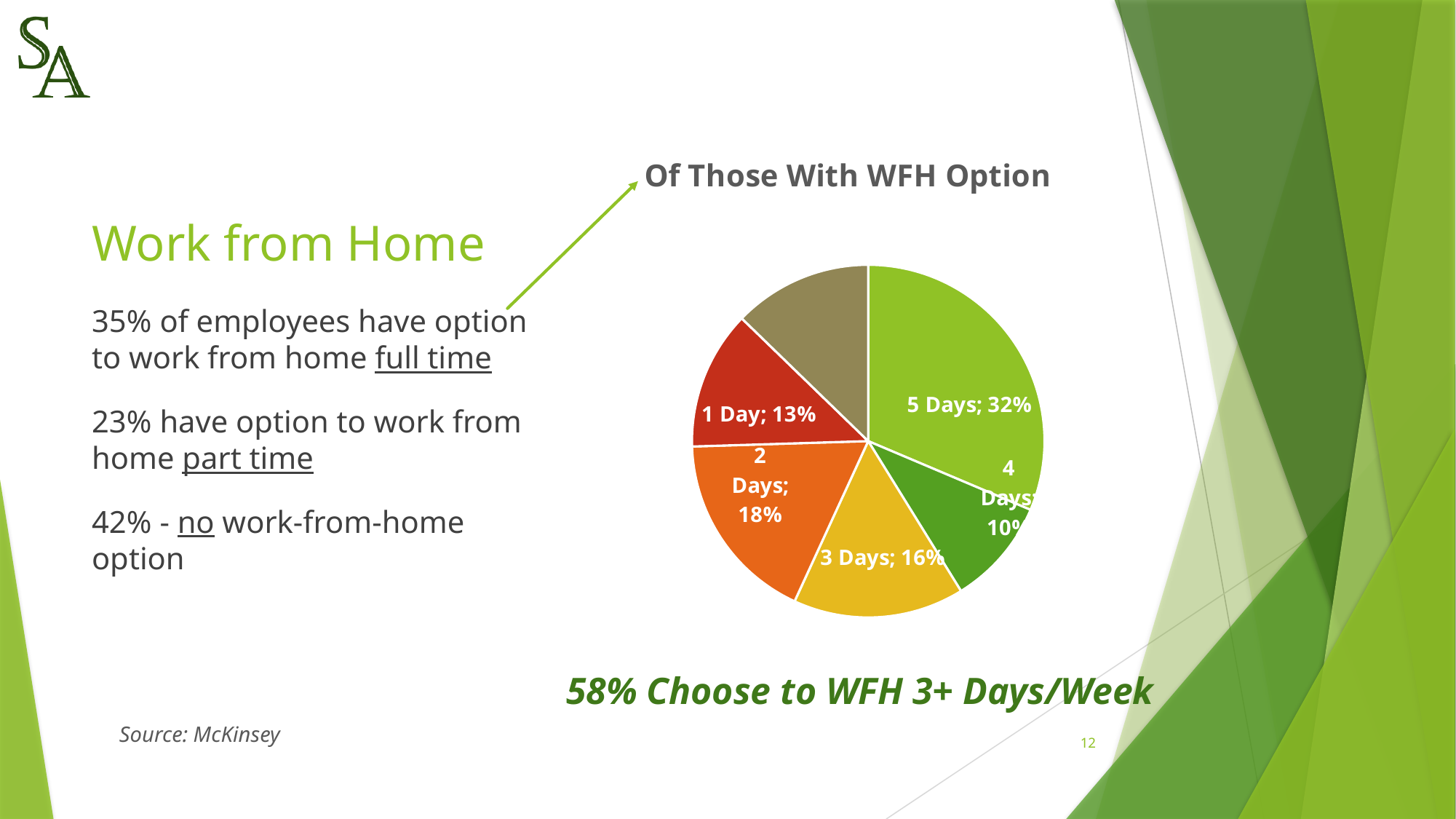
What percentage is shown for 3 Days? 16% What share of the pie is labelled for 5 Days? 32% Which labelled category has the largest slice of the pie? 5 Days What percentage is shown for 4 Days? 10% How many slices does the pie chart have? 6 Which is larger, the slice for 2 Days or the slice for 3 Days? 2 Days What is the combined share of the 3 Days, 4 Days and 5 Days slices? 58% What is the title of the pie chart? Of Those With WFH Option What kind of chart is shown on the slide? pie chart What percentage is shown for 1 Day? 13% What is the difference in percentage points between the 5 Days slice and the 2 Days slice? 14 What percentage is shown for 2 Days? 18%